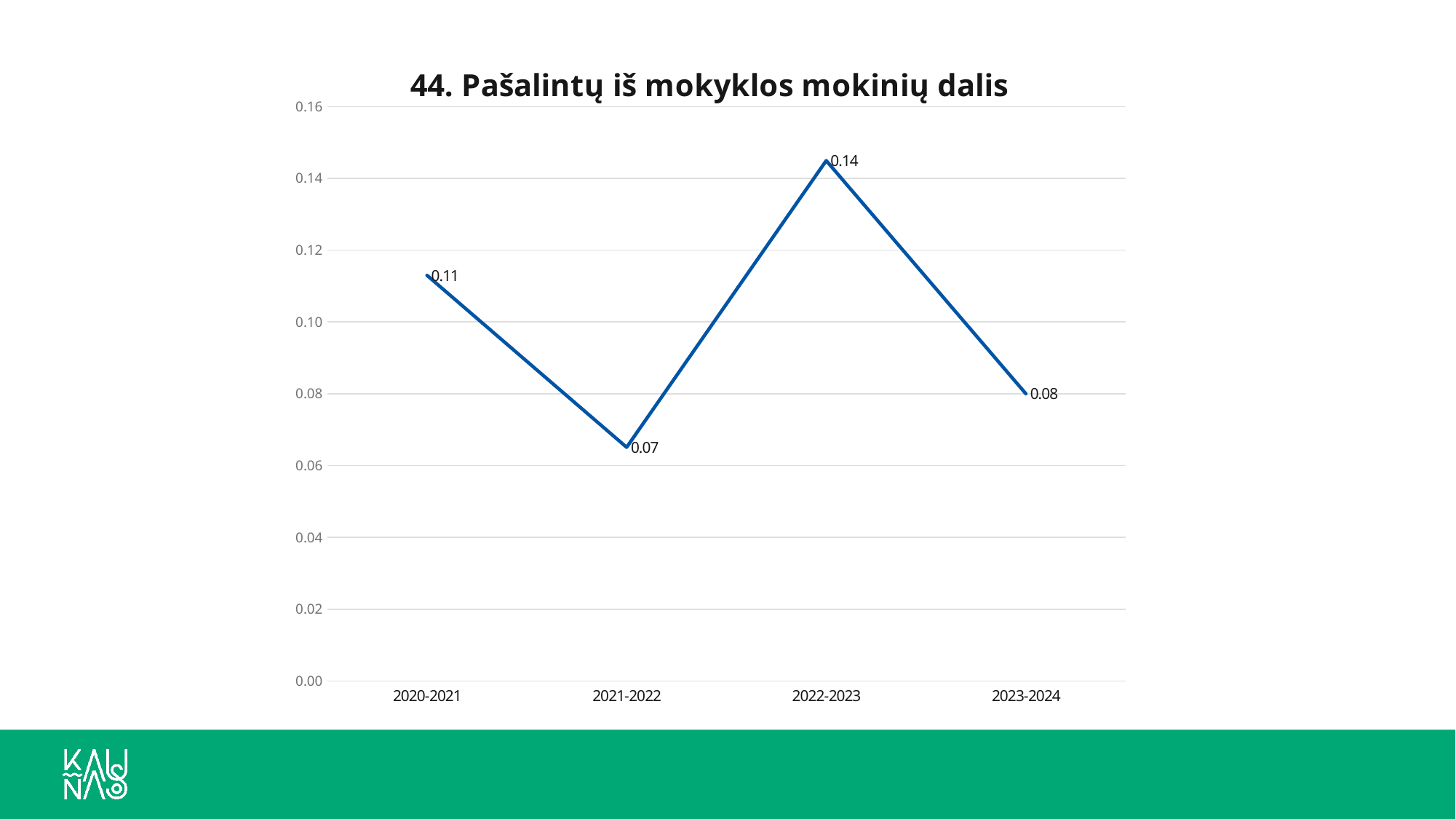
Which school year has the lowest value? 2021-2022 What is the value for 2021-2022? 0.07 What kind of chart is shown on the slide? line chart What is the value for 2020-2021? 0.11 Which is larger, the value for 2020-2021 or the value for 2023-2024? 2020-2021 What is the difference between the values for 2022-2023 and 2021-2022? 0.07 Which school year has the highest value? 2022-2023 Does the value rise or fall from 2022-2023 to 2023-2024? fall Is the value for 2022-2023 greater or less than 0.12? greater What is the value for 2022-2023? 0.14 What is the value for 2023-2024? 0.08 How many school years are plotted on the chart? 4